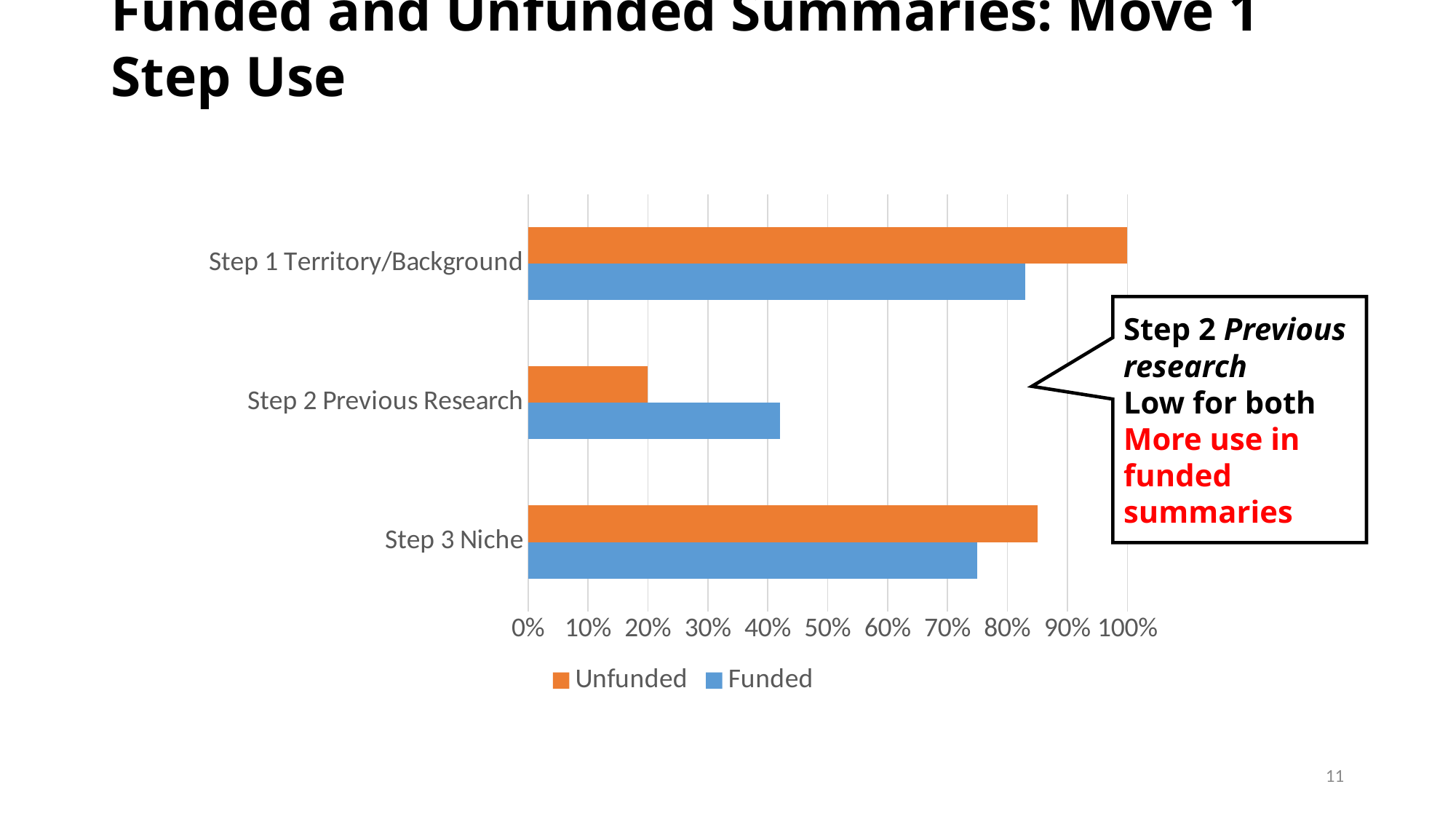
For Step 3 Niche, which is larger: the Funded or the Unfunded value? Unfunded What is the Unfunded value for Step 2 Previous Research? 20% What is the difference between the Unfunded values for Step 1 Territory/Background and Step 2 Previous Research? 80% What kind of chart is shown on the slide? bar chart What is the Unfunded value for Step 1 Territory/Background? 100% How many series does the legend list? 2 How many categories (steps) are plotted on the chart? 3 Which step has the highest Unfunded value? Step 1 Territory/Background Which step has the lowest Funded value? Step 2 Previous Research For Step 2 Previous Research, which is larger: the Funded or the Unfunded value? Funded Is the Funded value for Step 1 Territory/Background greater or less than 80%? greater Is the Funded value for Step 2 Previous Research greater or less than 50%? less